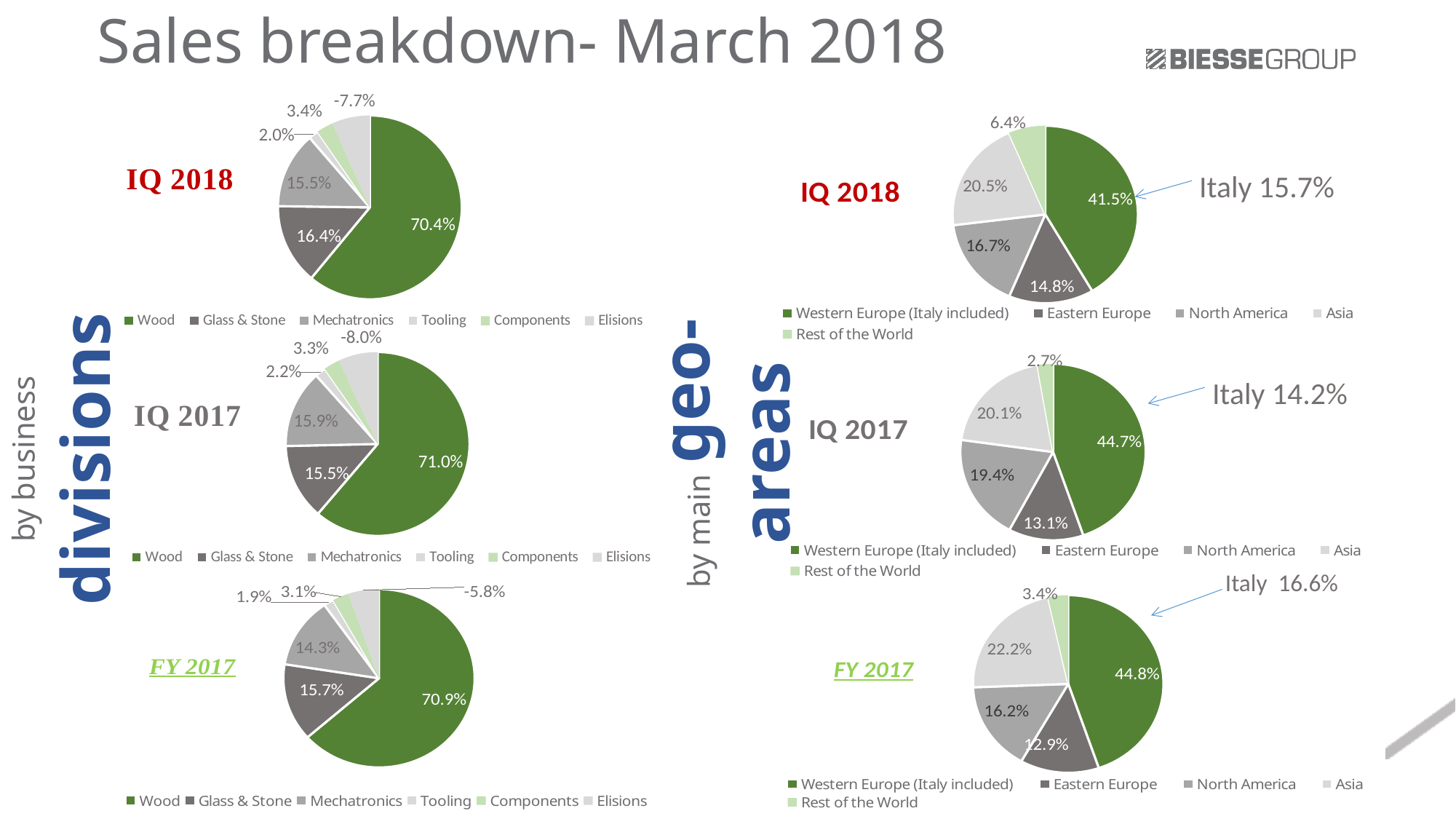
In the 'by main geo-areas' FY 2017 pie chart, which is larger: Asia or North America? Asia In the 'by main geo-areas' FY 2017 pie chart, what is the value for Eastern Europe? 12.9% In the 'by business divisions' IQ 2017 pie chart, what is the value for Mechatronics? 15.9% In the 'by main geo-areas' IQ 2018 pie chart, which category has the smallest share? Rest of the World In the 'by main geo-areas' IQ 2018 pie chart, what share does Asia have? 20.5% In the 'by business divisions' FY 2017 pie chart, what is the value for Glass & Stone? 15.7% How many categories does the legend list for the 'by business divisions' IQ 2018 pie chart? 6 In the 'by main geo-areas' IQ 2018 pie chart, what is the difference between the North America and Eastern Europe shares? 1.9% In the 'by business divisions' IQ 2018 pie chart, what share does Wood have? 70.4% What Italy share is annotated next to the 'by main geo-areas' IQ 2017 pie chart? Italy 14.2% In the 'by main geo-areas' IQ 2017 pie chart, which category has the largest share? Western Europe (Italy included) What type of chart is used for the 'by main geo-areas' FY 2017 breakdown? Pie chart